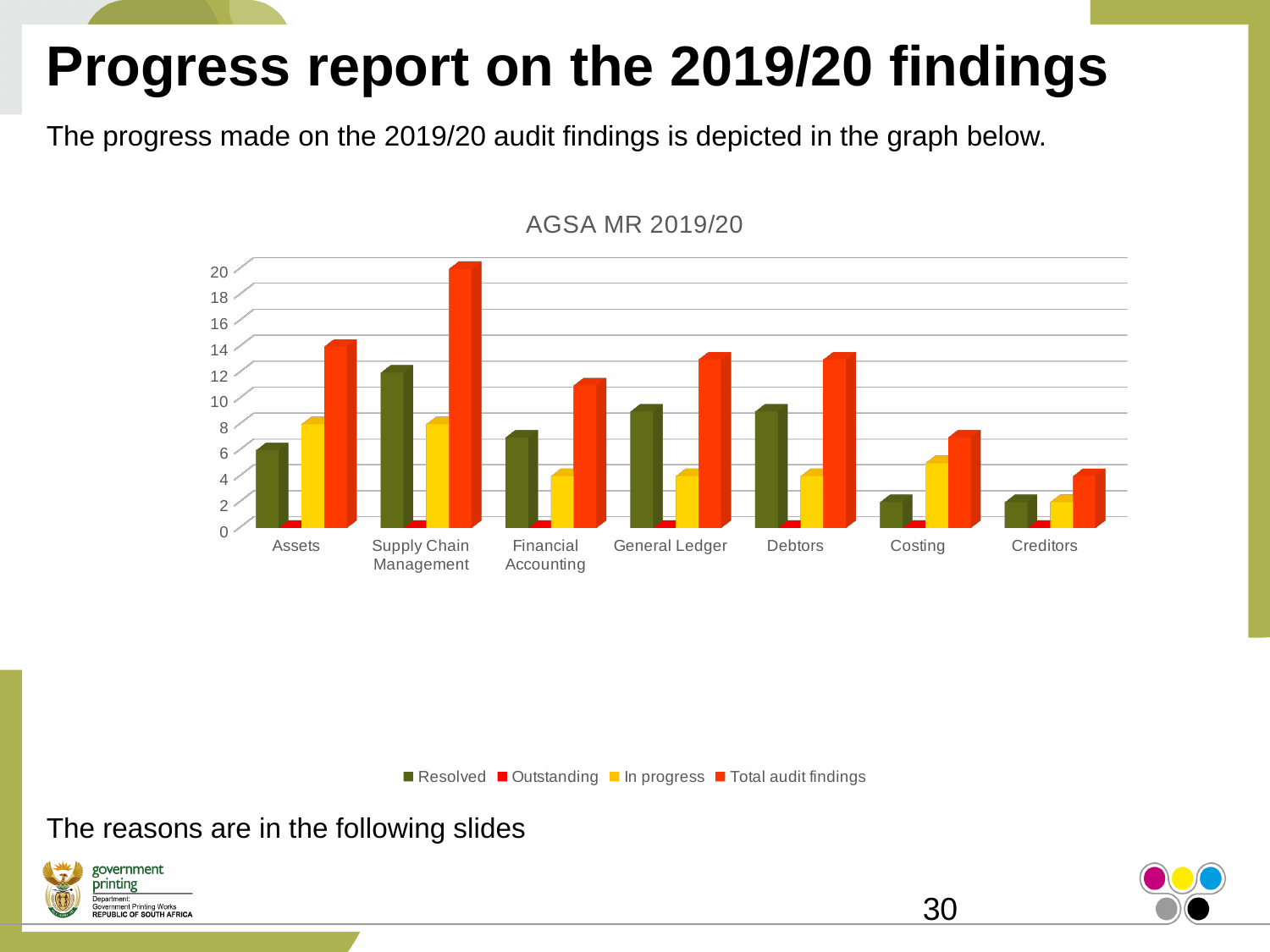
Which category has the highest Resolved bar? Supply Chain Management Is the Resolved value for Costing greater or less than 4? less How many categories are shown along the x axis of the chart? 7 Which is larger, the Total audit findings for Assets or for Financial Accounting? Assets How many series does the chart legend list? 4 Is the Total audit findings value for Creditors greater or less than 6? less What is the title of the chart? AGSA MR 2019/20 Which category has the highest Total audit findings bar? Supply Chain Management Is the Total audit findings value for Supply Chain Management greater or less than 18? greater Which category has the lowest Total audit findings bar? Creditors Which series is shown in yellow in the chart legend? In progress What kind of chart is shown on the slide? bar chart